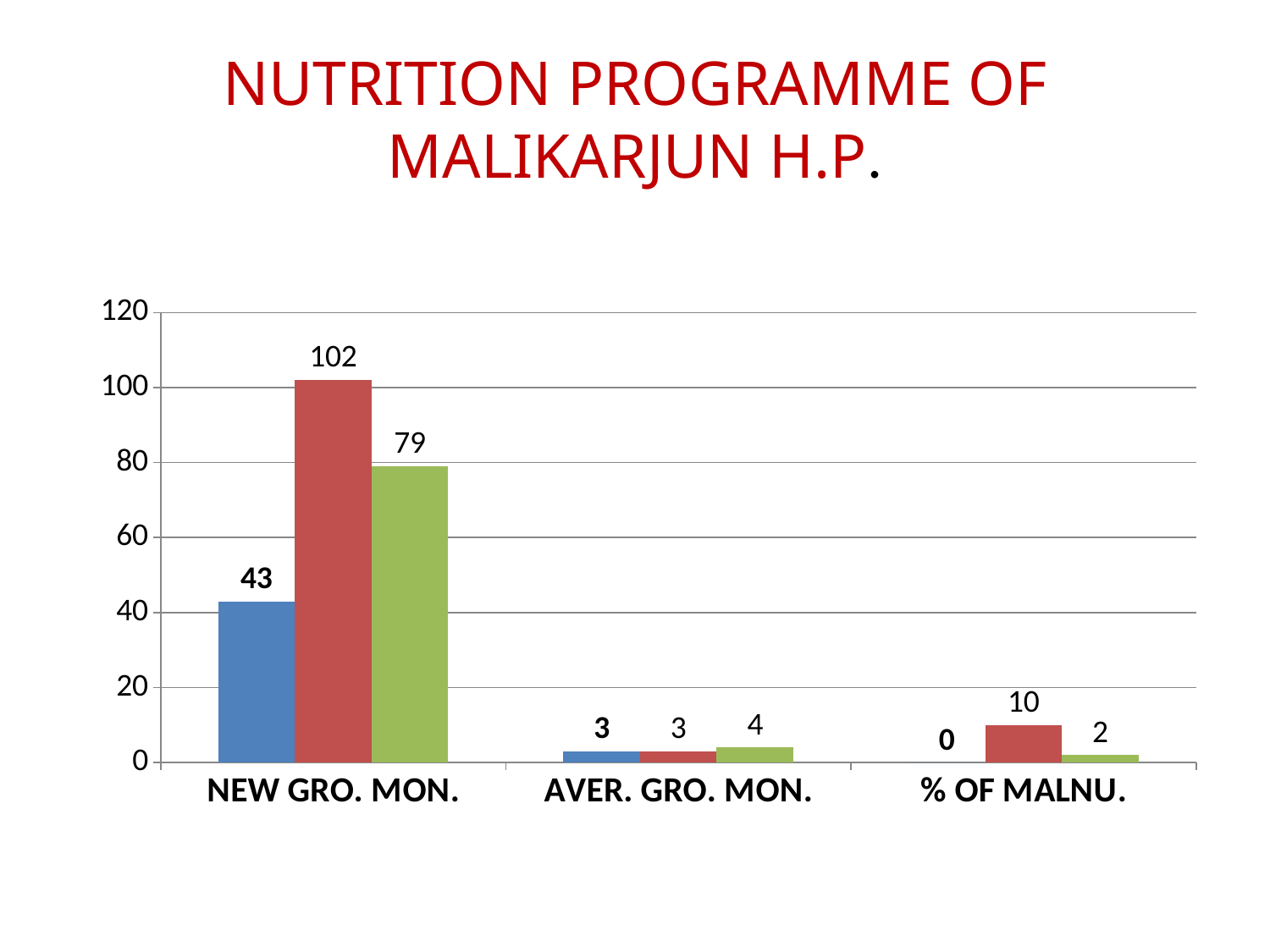
What kind of chart is shown on the slide? bar chart What is the value of the red bar for % OF MALNU.? 10 What is the value of the green bar for % OF MALNU.? 2 Which category has the highest red bar? NEW GRO. MON. Which category has the lowest blue bar? % OF MALNU. Is the value of the red bar for NEW GRO. MON. greater or less than 100? greater What is the value of the red bar for NEW GRO. MON.? 102 What is the title of the slide? NUTRITION PROGRAMME OF MALIKARJUN H.P. How many categories are shown on the x axis? 3 What is the difference between the red bar and the green bar for NEW GRO. MON.? 23 Which is larger for NEW GRO. MON., the blue bar or the green bar? the green bar What is the value of the blue bar for NEW GRO. MON.? 43